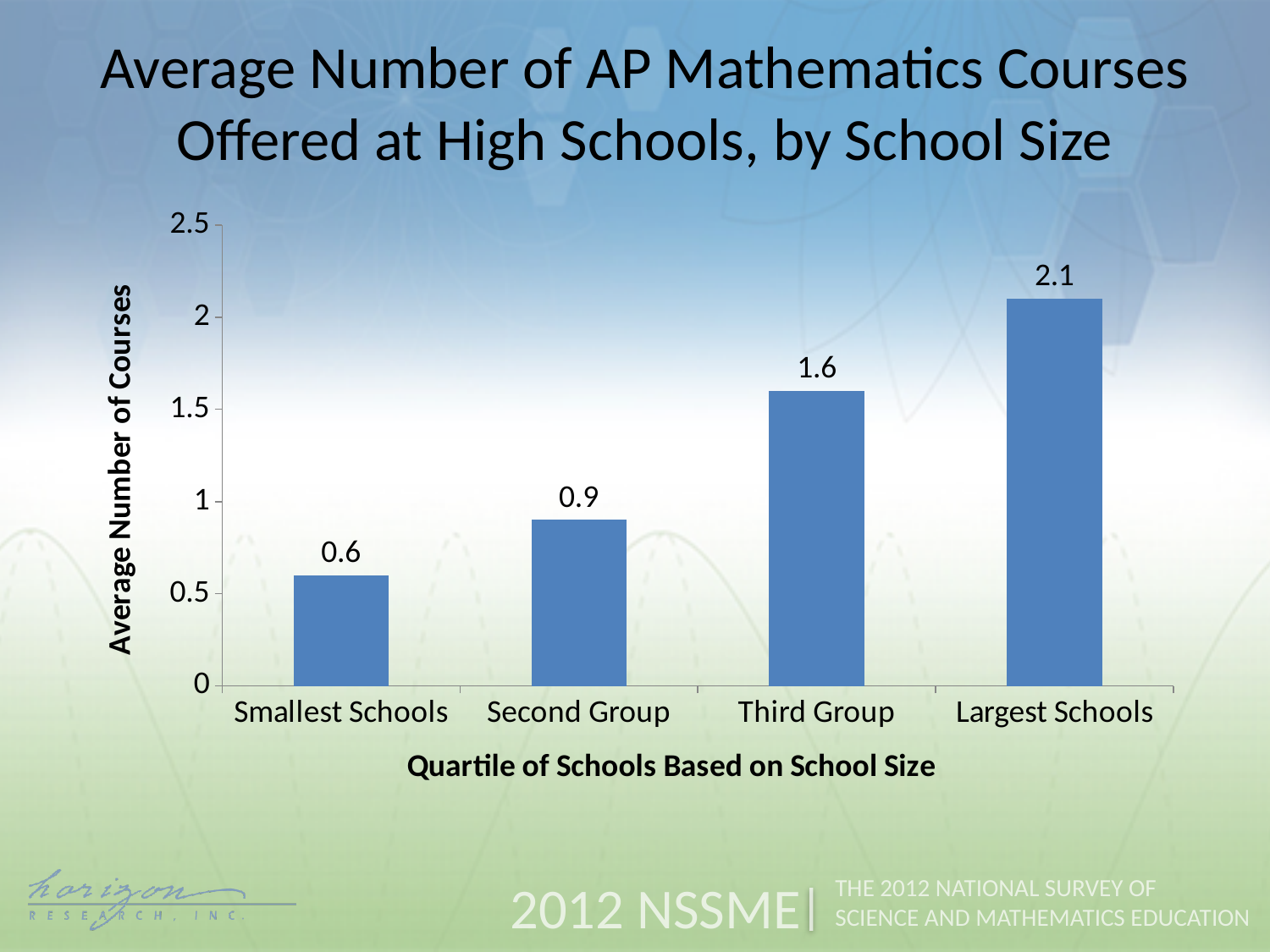
Is the value for the Largest Schools greater or less than 2? greater What is the value shown for the Third Group? 1.6 What is the average number of AP mathematics courses offered at the Smallest Schools? 0.6 Which quartile has the highest average number of AP mathematics courses? Largest Schools What kind of chart is shown on the slide? Bar chart How many quartile categories are shown on the x axis? 4 Which quartile has the lowest average number of AP mathematics courses? Smallest Schools What is the average number of AP mathematics courses offered at the Largest Schools? 2.1 What is the difference between the values for the Largest Schools and the Smallest Schools? 1.5 Which has a larger value, the Second Group or the Third Group? Third Group What is the difference between the values for the Third Group and the Second Group? 0.7 Do the values rise or fall moving from Smallest Schools to Largest Schools? Rise